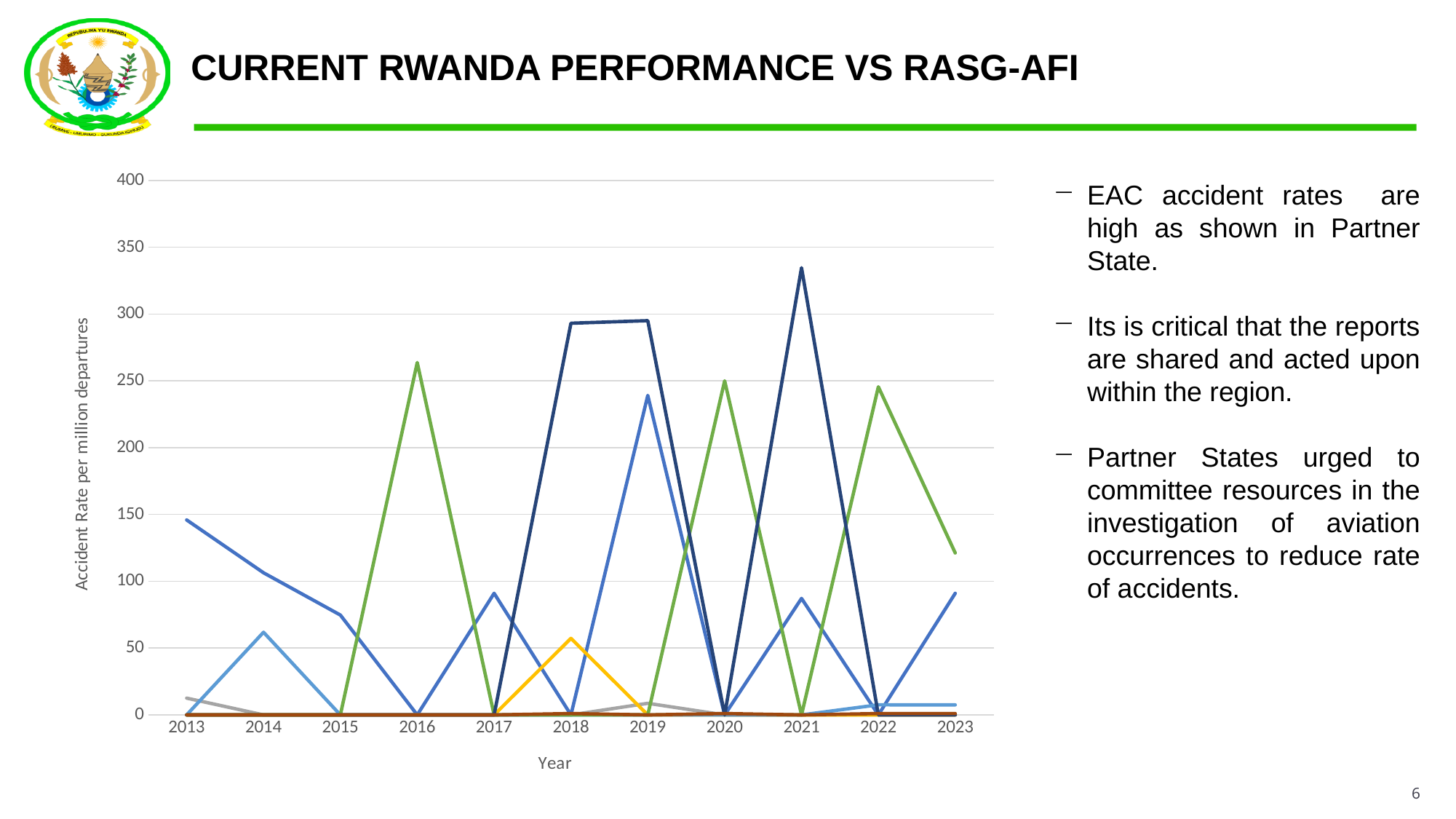
Is the value of the yellow line in 2018 greater or less than 100? less What kind of chart is shown on the slide? line chart Is the value of the dark navy line in 2021 greater or less than 300? greater How many years are shown along the x axis of the chart? 11 Is the value of the blue line in 2013 greater or less than 100? greater In which year does the dark navy line reach its highest value? 2021 What is the title of the horizontal axis of the chart? Year What is the title of the vertical axis of the chart? Accident Rate per million departures